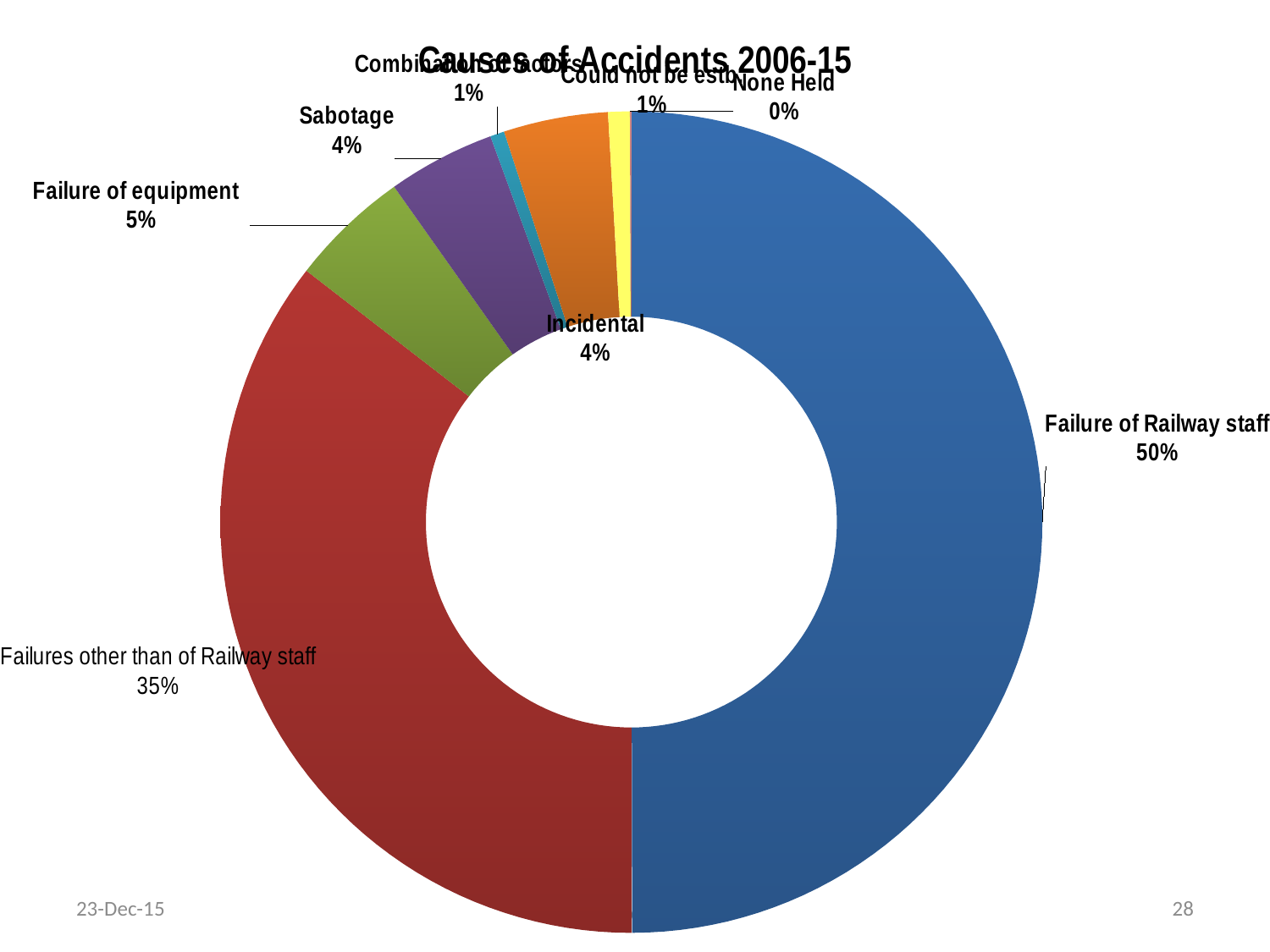
What percentage is shown for Failures other than of Railway staff? 35% How many percentage points larger is the share for Failure of Railway staff than for Failures other than of Railway staff? 15 percentage points Which cause accounts for the smallest share of accidents? None Held What percentage is shown for Incidental? 4% What percentage is shown for Failure of equipment? 5% Which cause accounts for the largest share of accidents? Failure of Railway staff What kind of chart is shown on the slide? Doughnut chart What share of accidents is attributed to Failure of Railway staff? 50% What percentage is shown for None Held? 0% Which has the larger share, Failure of equipment or Sabotage? Failure of equipment What is the title of the chart? Causes of Accidents 2006-15 What percentage is shown for Sabotage? 4%